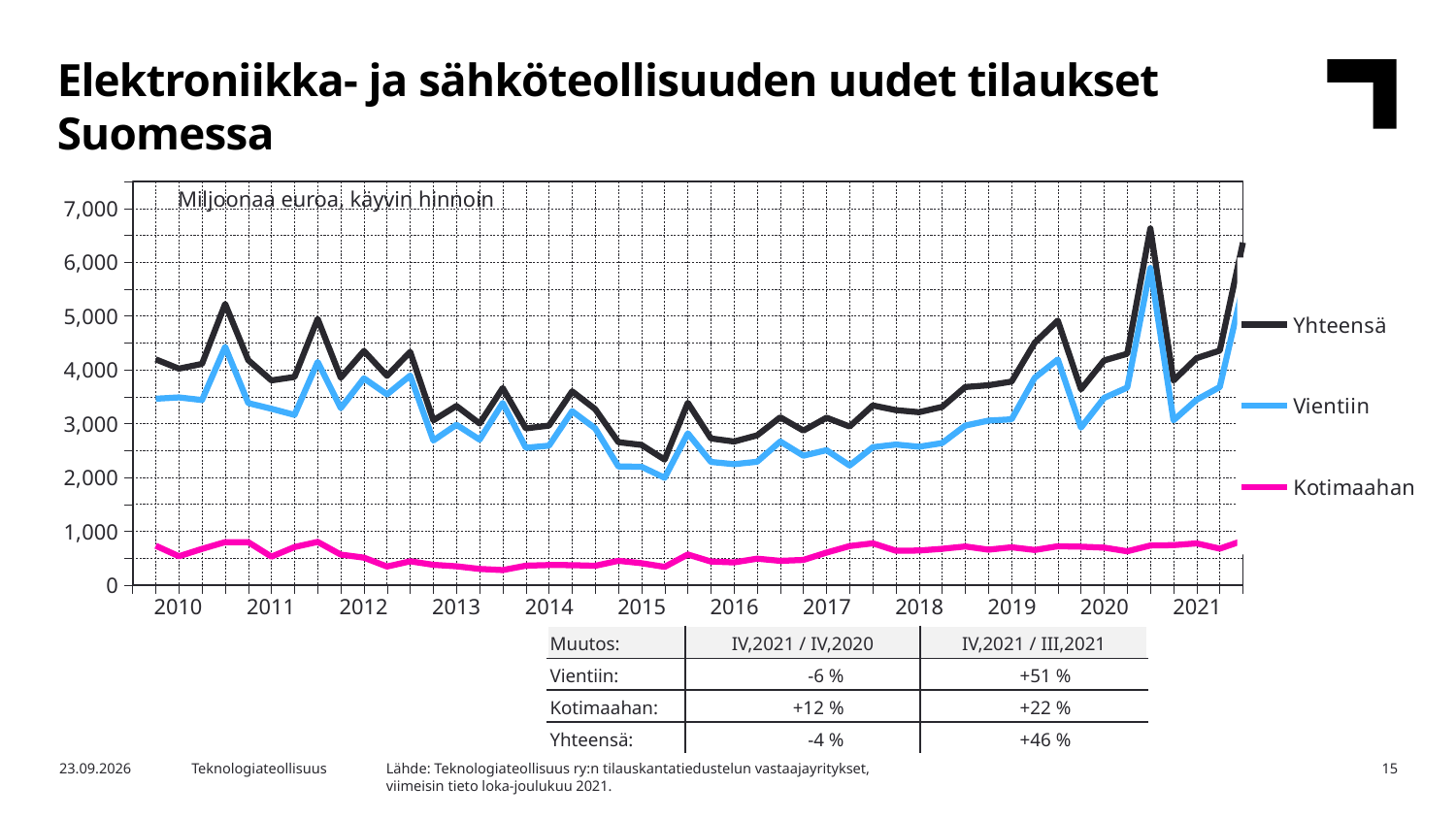
How many series does the legend list? 3 Which series is plotted with the highest values throughout the chart? Yhteensä Is the peak value for Yhteensä in 2020 greater or less than 6,000? greater Is the value for Yhteensä at the start of 2016 greater or less than 4,000? less Which series is plotted with the lowest values throughout the chart? Kotimaahan What kind of chart is shown on the slide? line chart Is the value for Kotimaahan in 2015 greater or less than 1,000? less Which is larger in 2019, the value for Vientiin or the value for Kotimaahan? Vientiin What unit is stated in the label at the top of the chart? Miljoonaa euroa, käyvin hinnoin Does the Yhteensä series generally rise or fall from 2016 to 2019? rise How many years are labelled on the x axis? 12